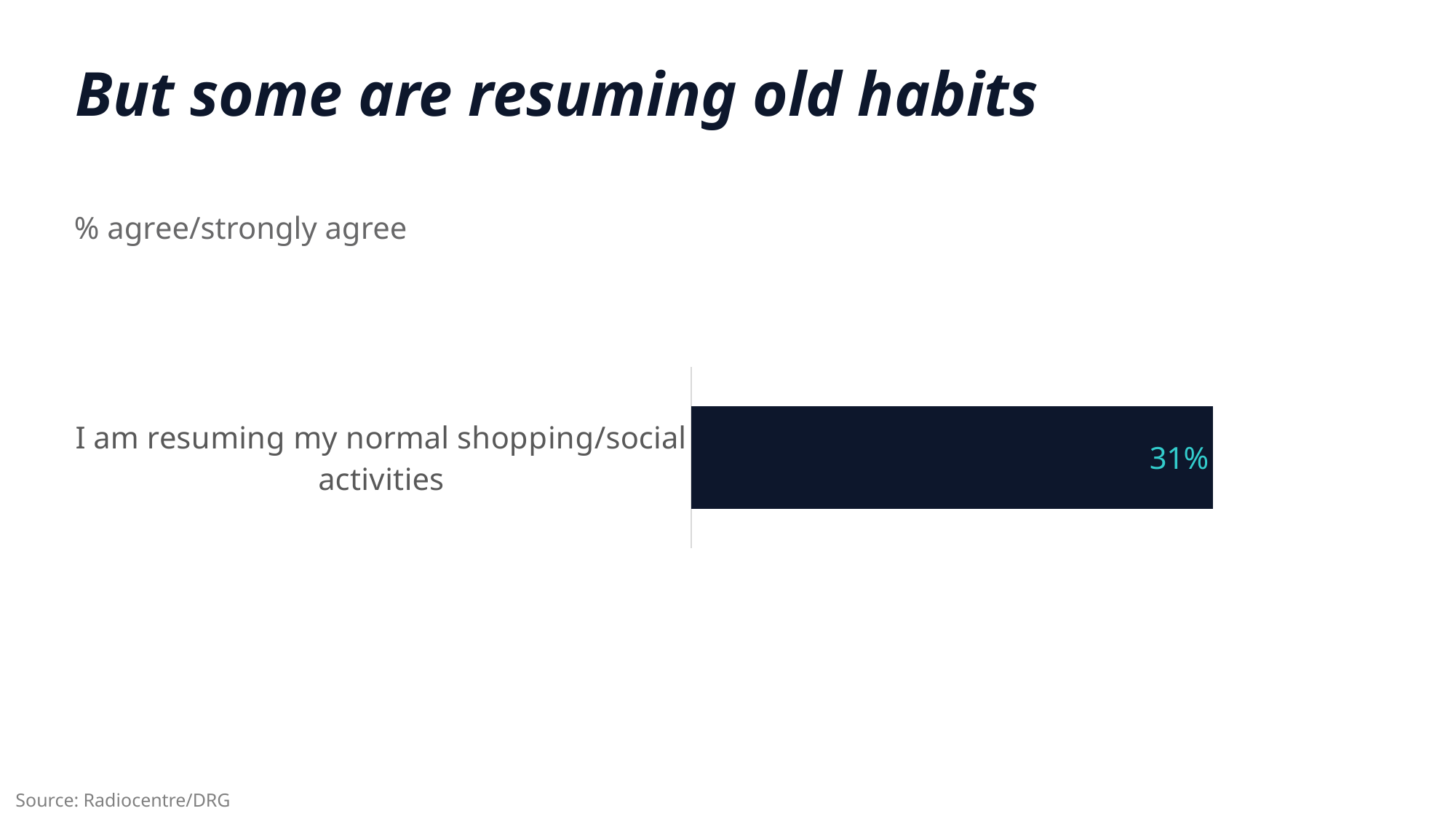
How many categories are plotted in the chart? 1 Is the value for "I am resuming my normal shopping/social activities" greater or less than 50%? less What is the title of the slide containing the chart? But some are resuming old habits What measure does the chart subtitle say the bar represents? % agree/strongly agree What kind of chart is shown on the slide? bar chart What percentage agree or strongly agree with "I am resuming my normal shopping/social activities"? 31% What is the label of the only category in the chart? I am resuming my normal shopping/social activities